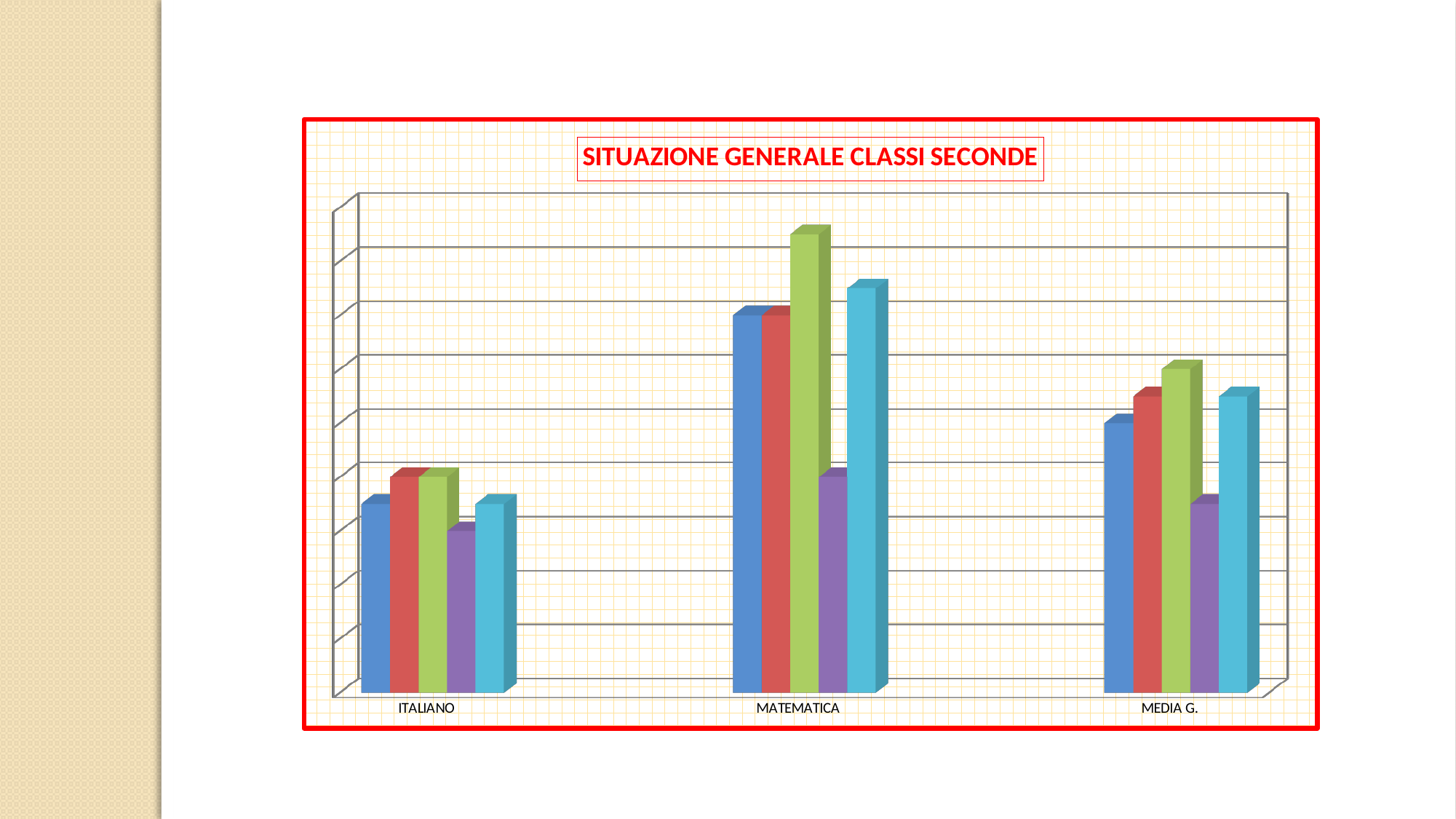
Which category has the tallest bar in the chart? MATEMATICA What kind of chart is shown on the slide? bar chart In the ITALIANO group, which is taller: the blue bar or the red bar? red How many categories are shown on the x axis of the chart? 3 Which coloured bar is the tallest in the MATEMATICA group? green In the MEDIA G. group, which is taller: the blue bar or the cyan bar? cyan Which coloured bar is the shortest in the ITALIANO group? purple How many bars are plotted for each category in the chart? 5 What is the title of the chart? SITUAZIONE GENERALE CLASSI SECONDE Which category has the shortest bars overall in the chart? ITALIANO Which coloured bar is the tallest in the MEDIA G. group? green Which coloured bar is the shortest in the MATEMATICA group? purple